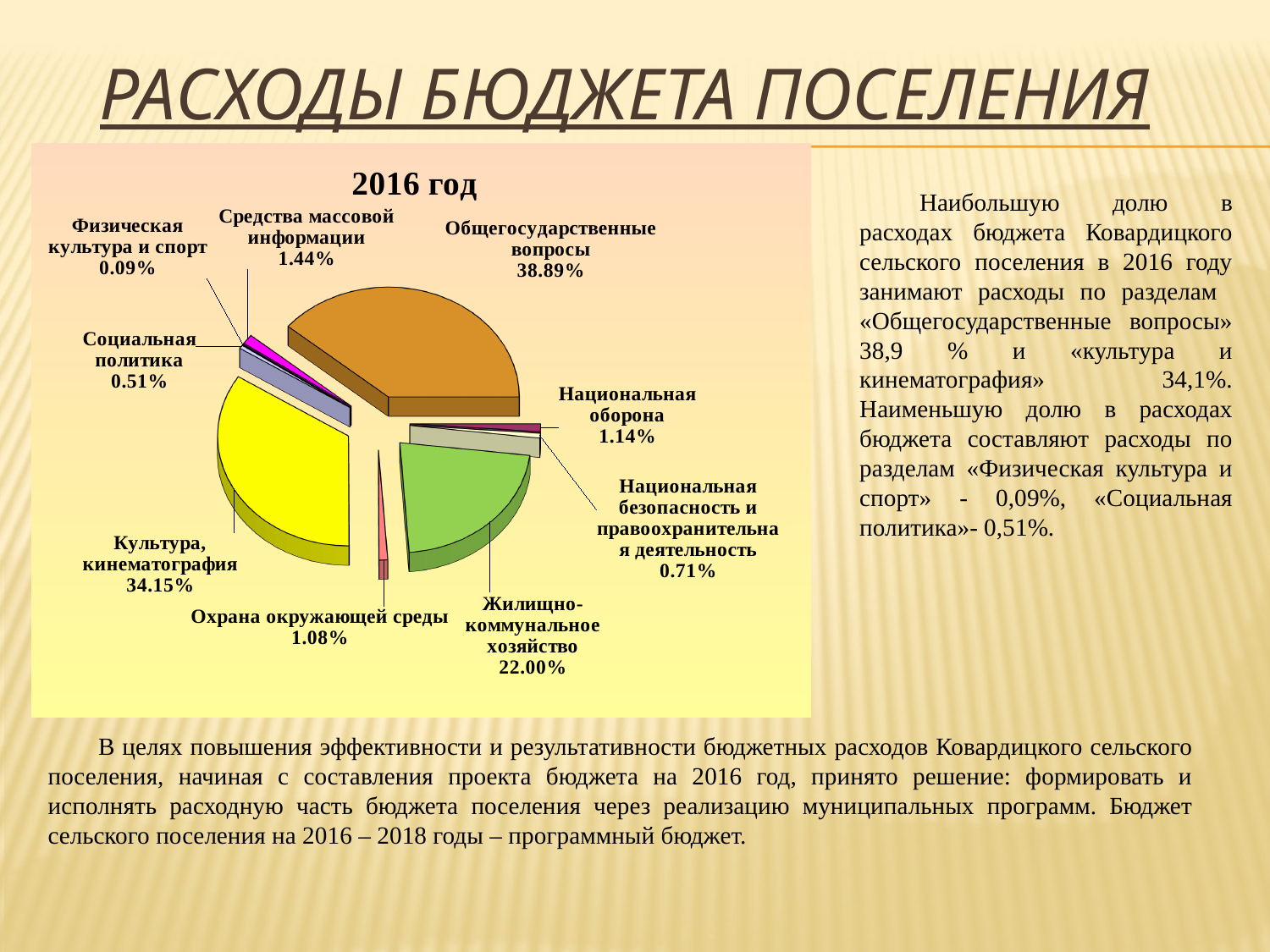
What share of the pie does "Общегосударственные вопросы" take? 38.89% What kind of chart is shown on the slide? Pie chart What is the value shown for "Культура, кинематография"? 34.15% What is the value shown for "Национальная оборона"? 1.14% What is the value shown for "Социальная политика"? 0.51% What is the value shown for "Жилищно-коммунальное хозяйство"? 22.00% Which is larger: "Средства массовой информации" or "Охрана окружающей среды"? Средства массовой информации Which category has the largest share of the pie? Общегосударственные вопросы What is the difference between the shares of "Общегосударственные вопросы" and "Культура, кинематография"? 4.74% Which category has the smallest share of the pie? Физическая культура и спорт What is the title of the chart? 2016 год How many categories are shown in the pie chart? 9